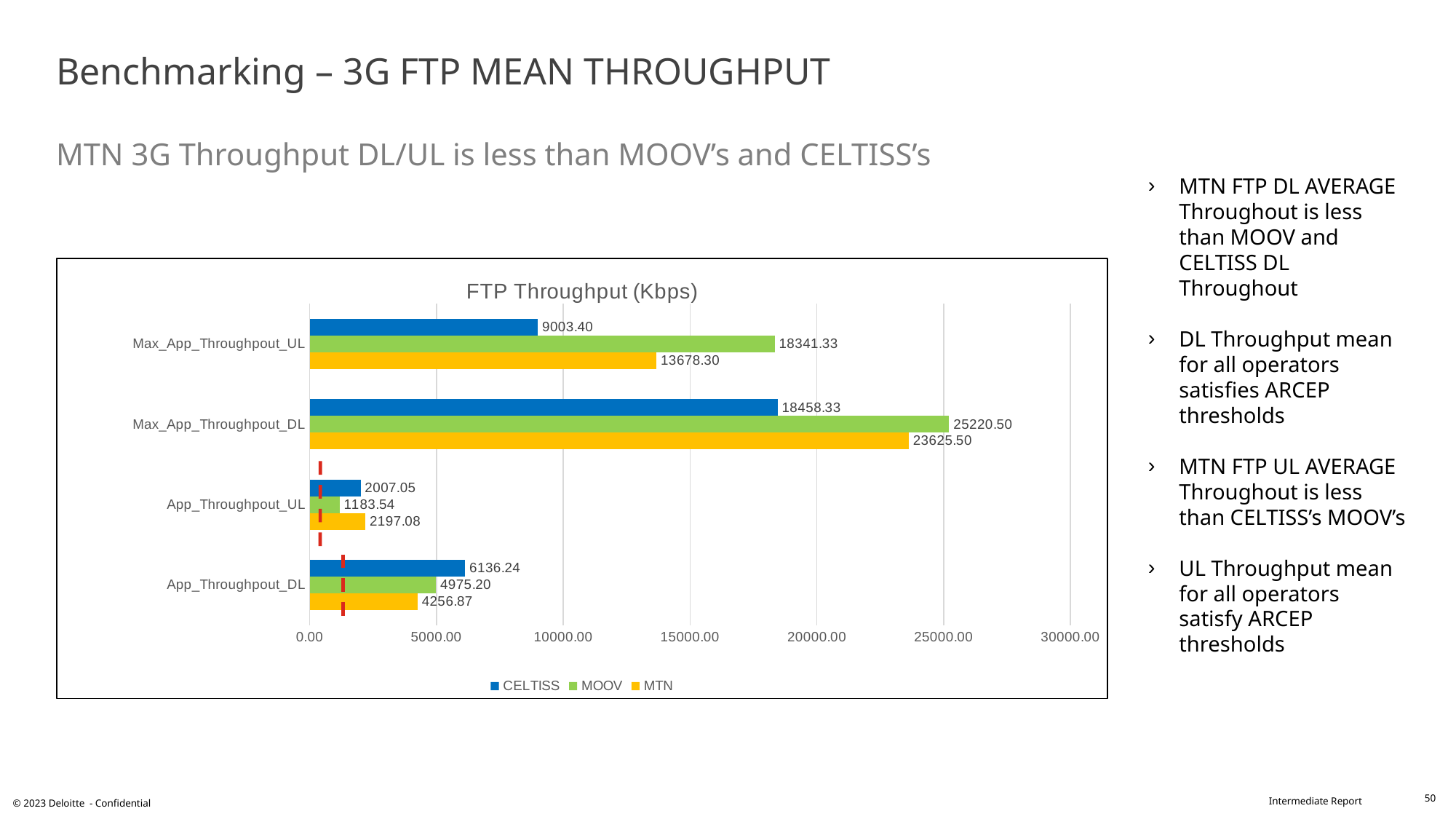
What kind of chart is shown on the slide? bar chart Which is larger for App_Throughpout_UL: the MTN value or the MOOV value? MTN What is the CELTISS value for App_Throughpout_UL? 2007.05 What is the MOOV value for Max_App_Throughpout_DL? 25220.50 Which operator has the highest value for App_Throughpout_DL? CELTISS How many categories are shown on the y axis of the chart? 4 What is the difference between the MOOV and CELTISS values for Max_App_Throughpout_UL? 9337.93 How many series does the legend list? 3 Is the MTN value for Max_App_Throughpout_DL greater or less than 20000.00? greater Which operator has the lowest value for Max_App_Throughpout_UL? CELTISS What is the title of the chart? FTP Throughput (Kbps) What is the MTN value for Max_App_Throughpout_UL? 13678.30